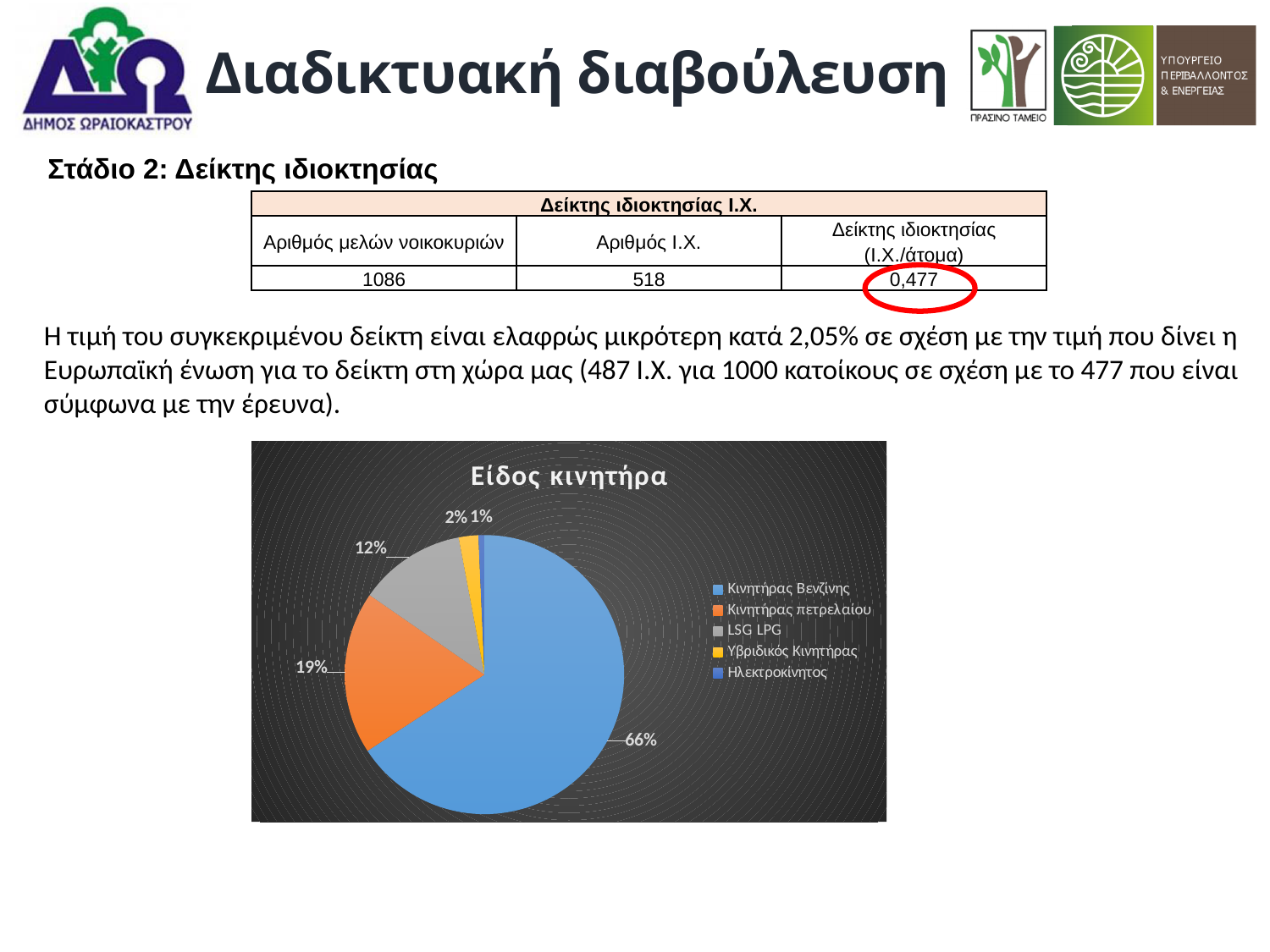
What type of chart is shown on the slide? pie chart Which category has the largest slice of the pie? Κινητήρας Βενζίνης What share of the pie does LSG LPG have? 12% What share of the pie does Ηλεκτροκίνητος have? 1% How many categories does the pie chart show? 5 What is the difference in percentage points between Κινητήρας Βενζίνης and Κινητήρας πετρελαίου? 47 Which is larger, the share for Κινητήρας πετρελαίου or the share for LSG LPG? Κινητήρας πετρελαίου What share of the pie does Κινητήρας πετρελαίου have? 19% What is the title of the chart? Είδος κινητήρα Which category has the smallest slice of the pie? Ηλεκτροκίνητος